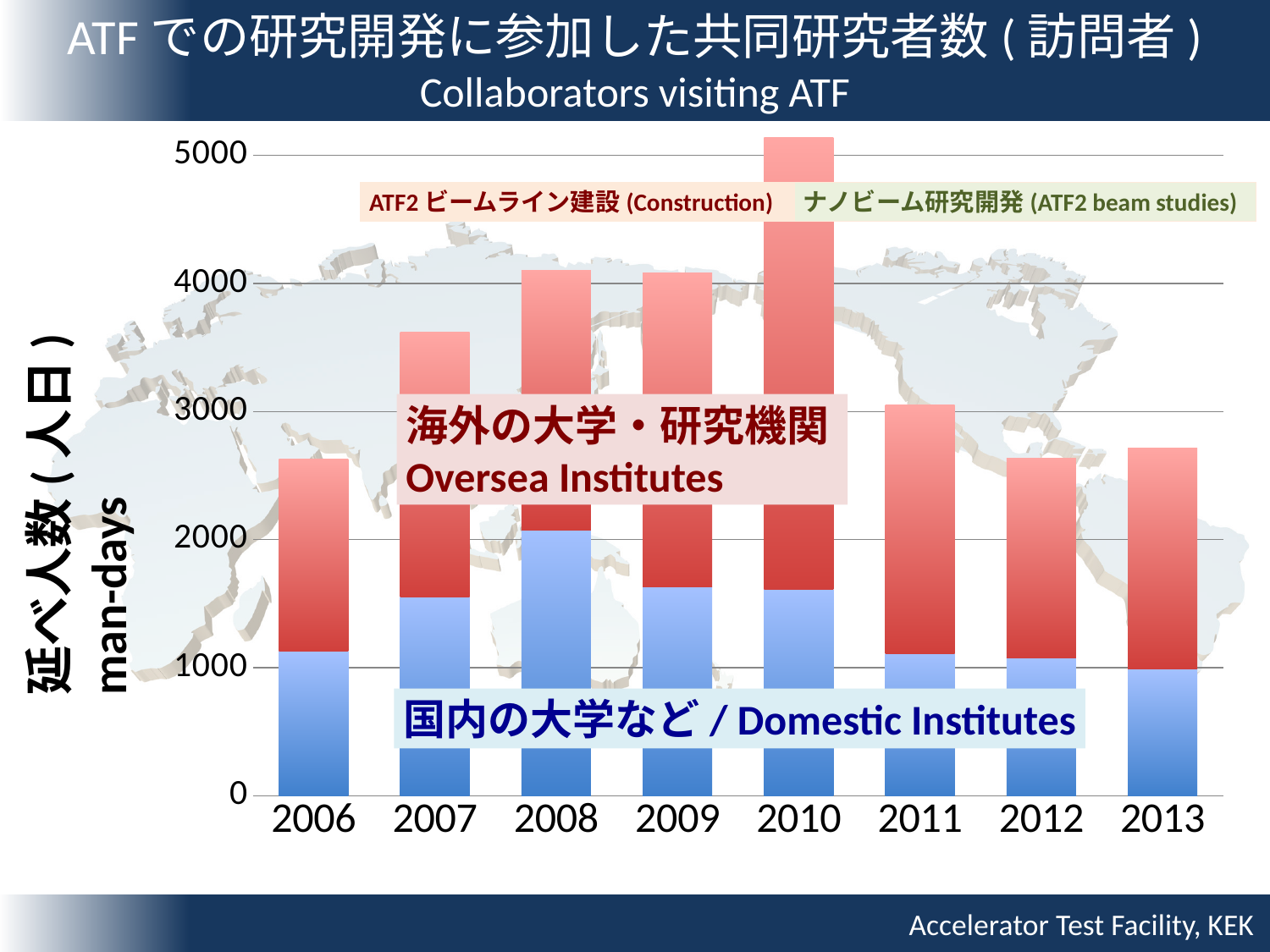
Which year has the highest total man-days in the chart? 2010 How many years are shown along the x axis of the chart? 8 Which year has a larger total, 2006 or 2007? 2007 Is the total value for 2006 greater or less than 3000? less Is the total value for 2007 greater or less than 4000? less What is the English title of the chart on the slide? Collaborators visiting ATF Which year has the largest Domestic Institutes (blue) segment? 2008 Is the Domestic Institutes value for 2008 greater or less than 2000? greater Do the total man-days rise or fall from 2010 to 2013? Fall What kind of chart is shown on the slide? Stacked bar chart How many series are stacked in each bar of the chart? 2